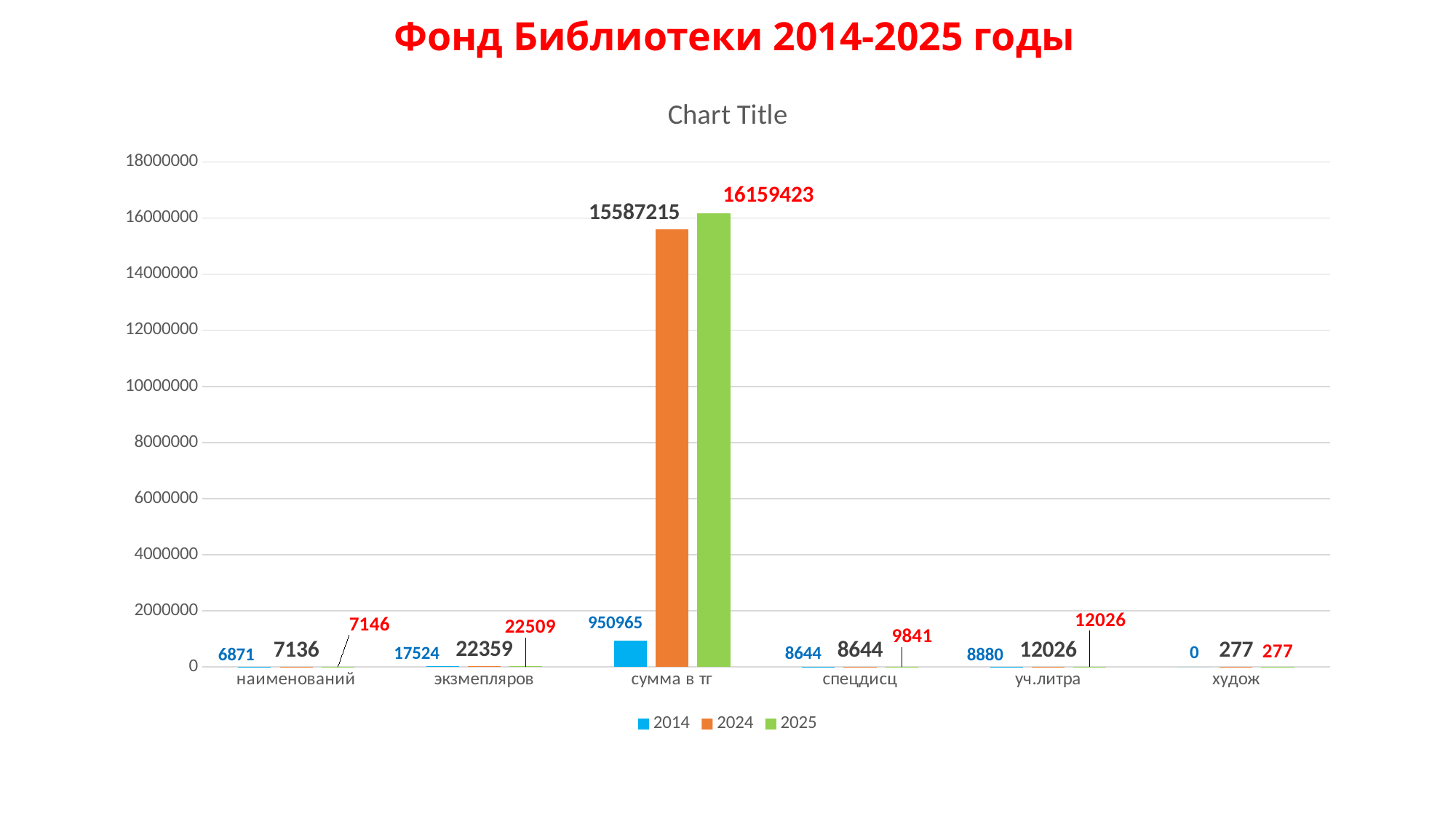
What kind of chart is shown on the slide? bar chart What is the value for 2014 in the худож category? 0 How many series does the legend list? 3 What is the value for 2025 in the сумма в тг category? 16159423 Which category has the highest value for the 2024 series? сумма в тг What is the value for 2014 in the экзмепляров category? 17524 Which is larger in the спецдисц category: the 2025 value or the 2014 value? 2025 What is the difference between the 2025 and 2024 values in the сумма в тг category? 572208 How many categories are shown on the x axis? 6 Which category has the lowest value for the 2025 series? худож What is the difference between the 2025 and 2014 values in the наименований category? 275 What is the value for 2024 in the уч.литра category? 12026